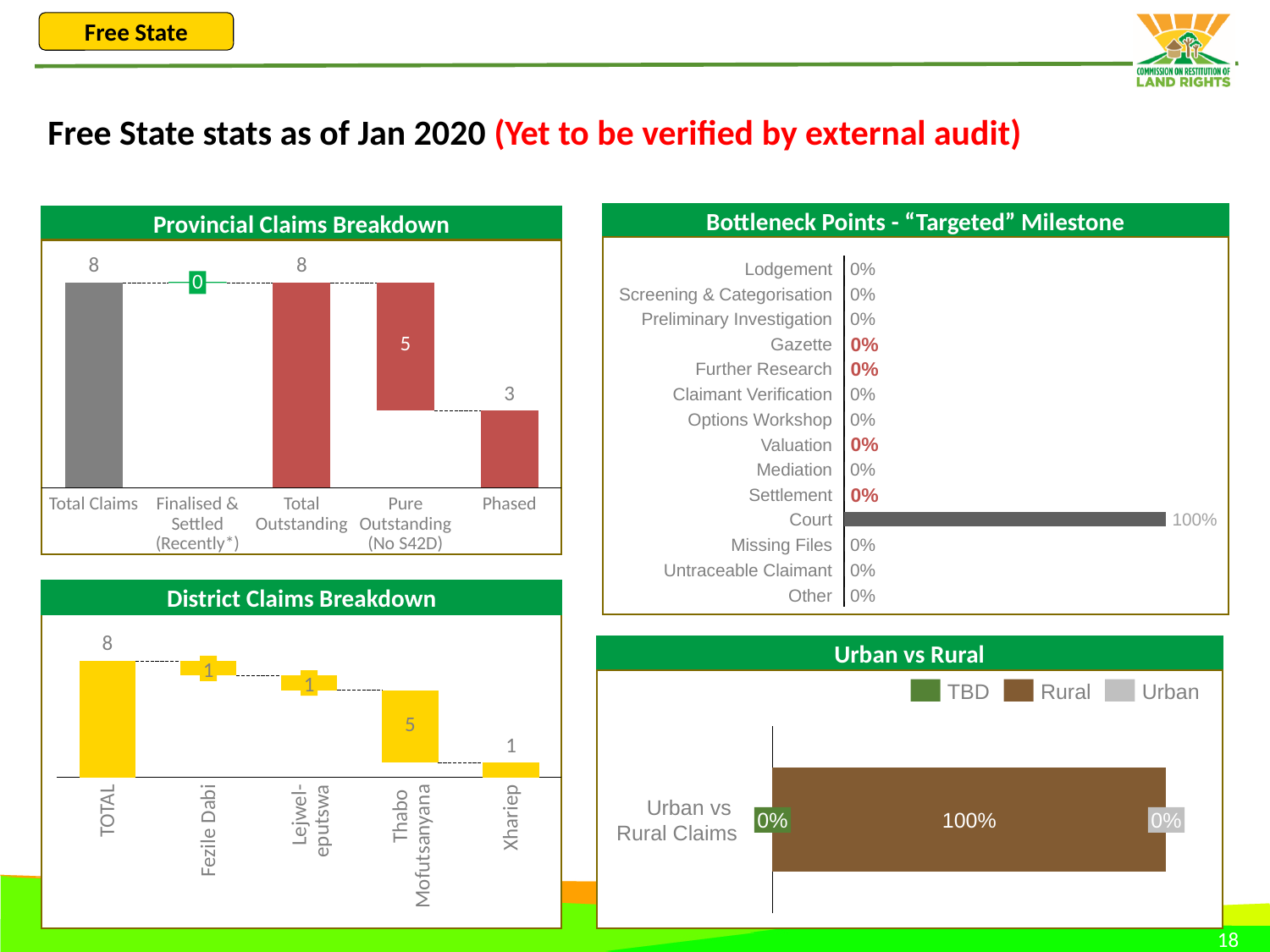
In the District Claims Breakdown chart, what is the value for Thabo Mofutsanyana? 5 In the Bottleneck Points chart, what is the value for Court? 100% In the Provincial Claims Breakdown chart, what is the value for Pure Outstanding (No S42D)? 5 In the District Claims Breakdown chart, which district (excluding TOTAL) has the highest value? Thabo Mofutsanyana In the Provincial Claims Breakdown chart, what is the value for Total Claims? 8 In the District Claims Breakdown chart, how many categories are shown on the x axis? 5 In the Urban vs Rural chart, how many series does the legend list? 3 In the Provincial Claims Breakdown chart, which category has the lowest value? Finalised & Settled (Recently*) In the Provincial Claims Breakdown chart, what is the difference between Total Outstanding and Phased? 5 In the Bottleneck Points chart, which category has the highest value? Court In the Bottleneck Points chart, how many categories are listed? 14 In the Urban vs Rural chart, what is the value for Rural? 100%